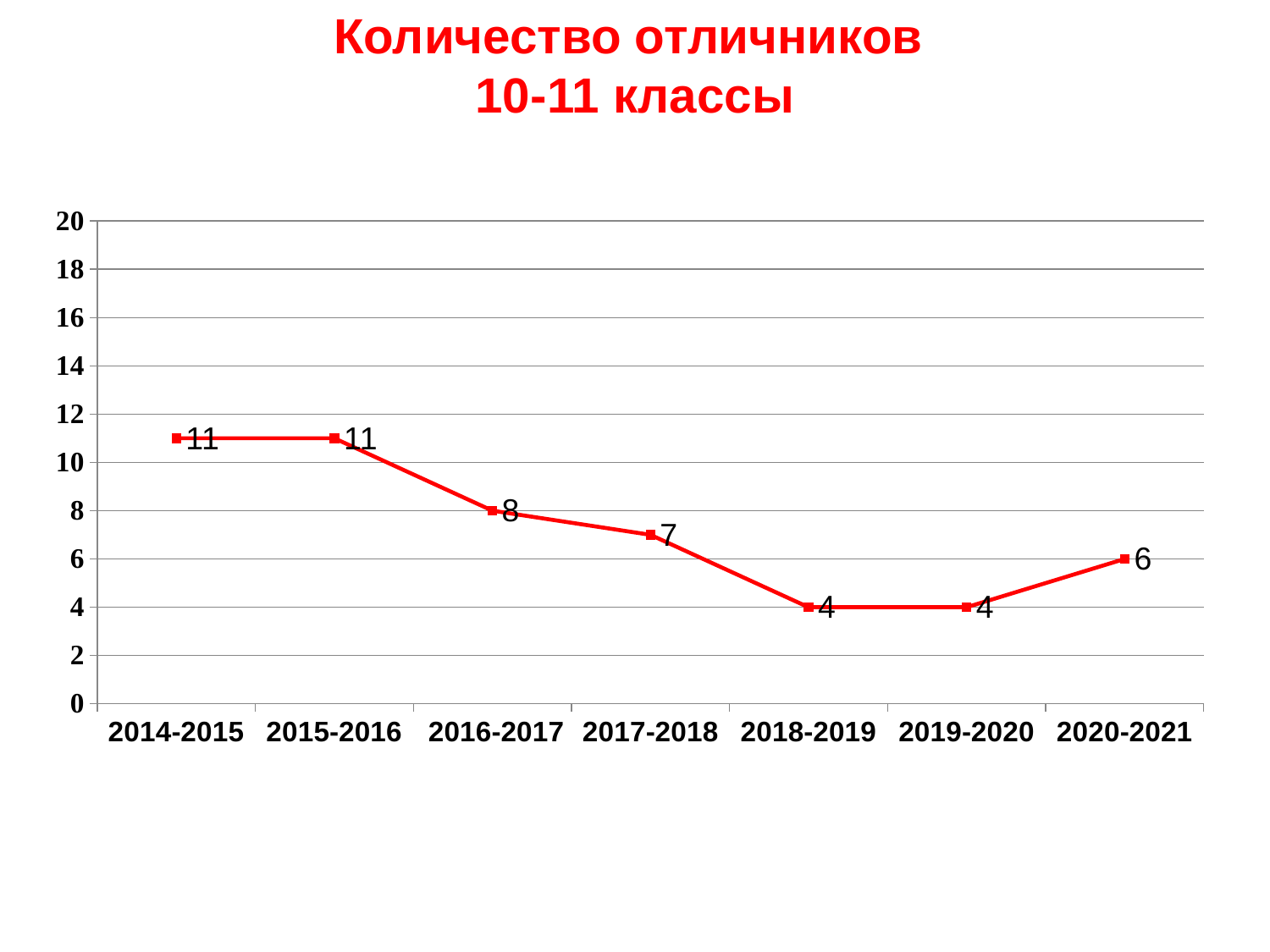
Which is larger, the value for 2017-2018 or the value for 2020-2021? 2017-2018 What is the value for 2016-2017? 8 What kind of chart is shown on the slide? line chart What is the value for 2017-2018? 7 Is the value for 2016-2017 greater or less than 10? less What is the highest value shown on the chart? 11 How many school years are plotted on the chart? 7 What is the title of the chart? Количество отличников 10-11 классы Which year has the lowest value? 2018-2019 and 2019-2020 What is the difference between the values for 2015-2016 and 2016-2017? 3 What is the difference between the values for 2014-2015 and 2020-2021? 5 What is the value for 2020-2021? 6